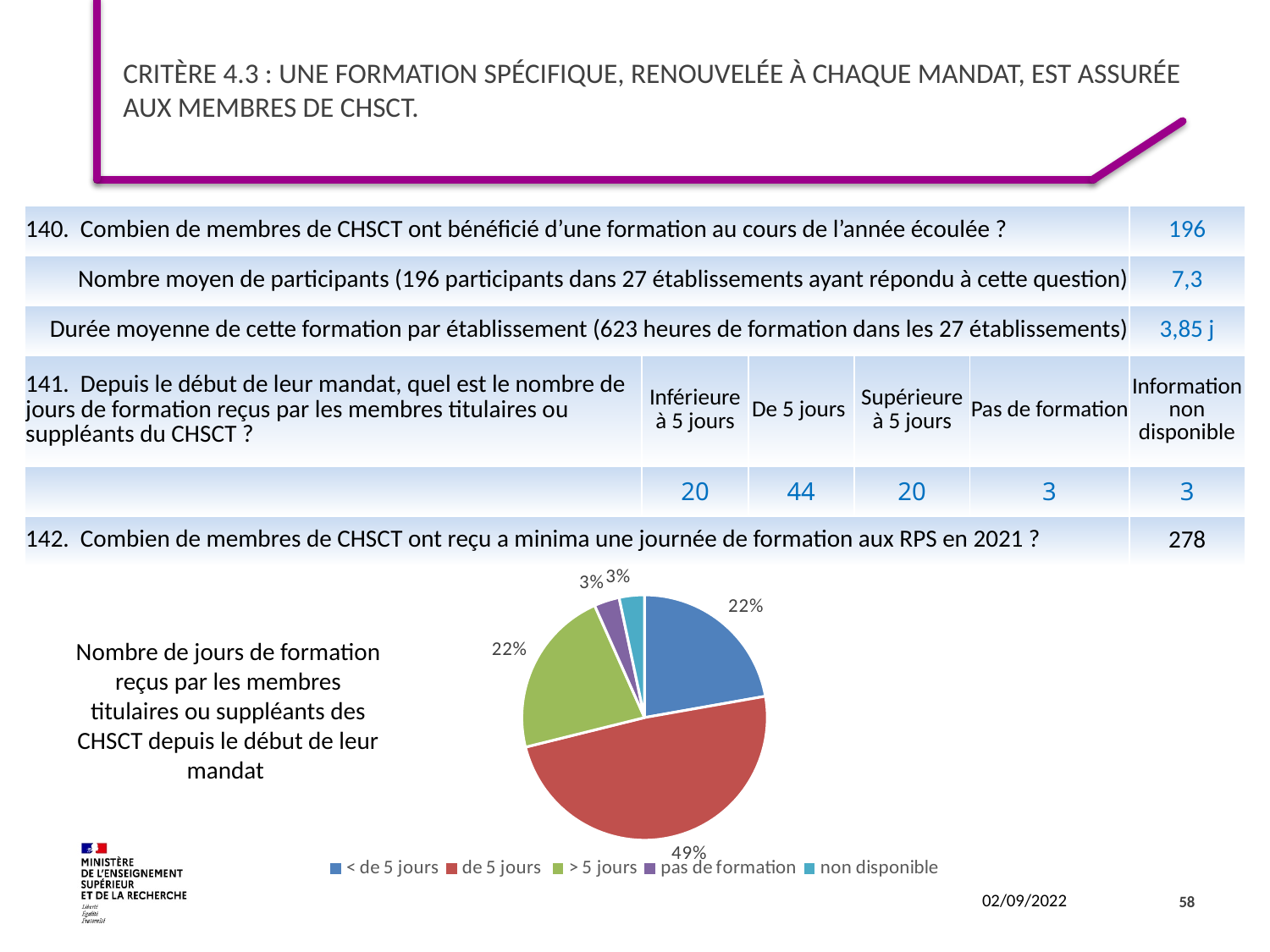
How many slices does the pie chart have? 5 What share of the pie does the "de 5 jours" slice represent? 49% What colour is the "de 5 jours" slice in the pie chart? red Which is larger: the share for "de 5 jours" or the share for "> 5 jours"? de 5 jours What share of the pie does the "< de 5 jours" slice represent? 22% What share of the pie does the "pas de formation" slice represent? 3% Which category has the largest slice of the pie? de 5 jours How many entries does the legend of the pie chart list? 5 What kind of chart is shown on the slide? pie chart What is the difference in percentage points between the "de 5 jours" slice and the "< de 5 jours" slice? 27%